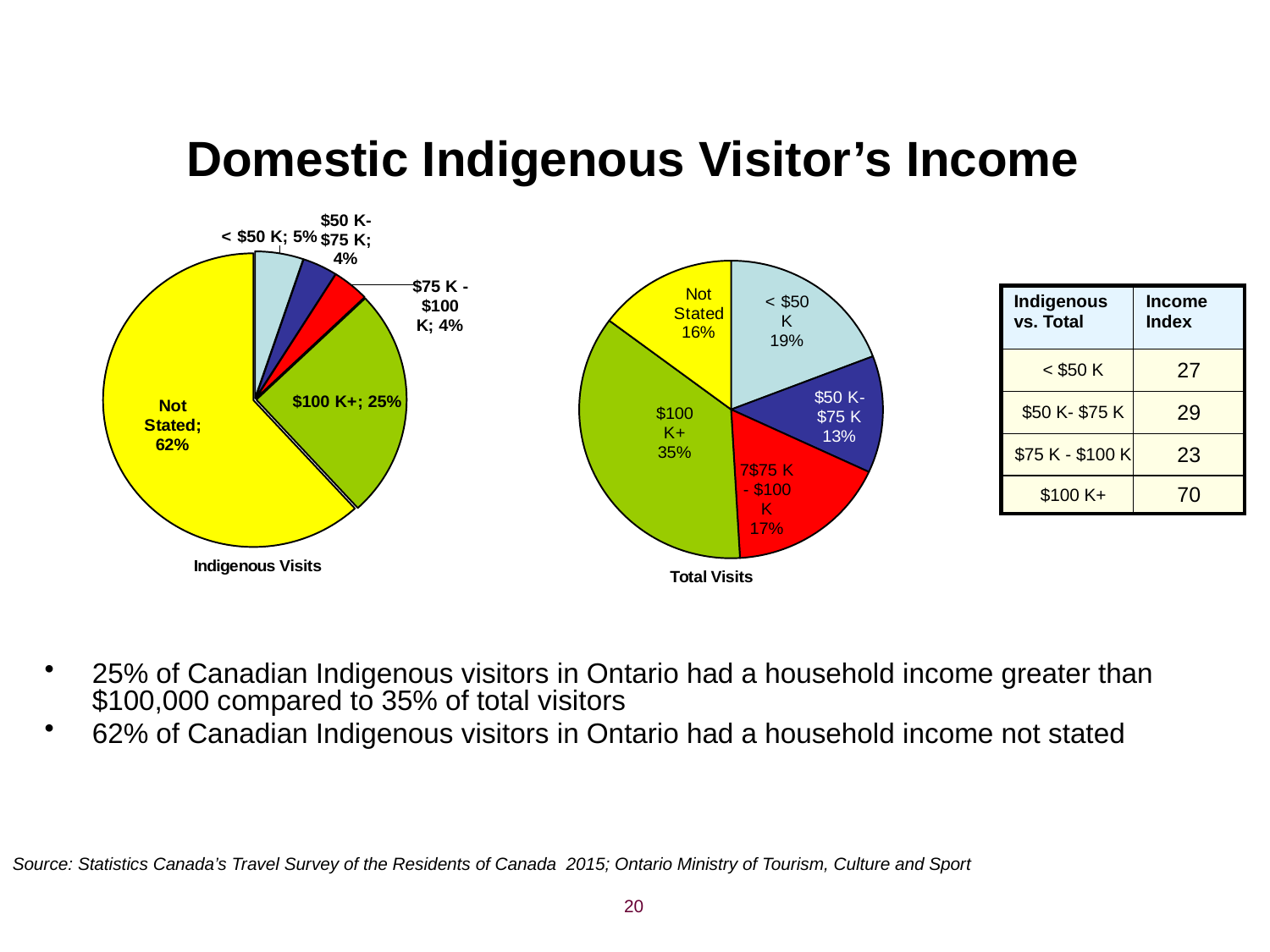
In the Indigenous Visits pie chart, what share of visits is Not Stated? 62% What is the difference between the $100 K+ share in the Total Visits pie chart and the $100 K+ share in the Indigenous Visits pie chart? 10 percentage points In the Indigenous Visits pie chart, which income category has the smallest share? $50 K-$75 K and $75 K - $100 K (both 4%) In the Total Visits pie chart, what share of visits is < $50 K? 19% In the Indigenous Visits pie chart, what share of visits is $100 K+? 25% In the Total Visits pie chart, which income category has the smallest share? $50 K-$75 K In the Indigenous Visits pie chart, what colour is the Not Stated slice? Yellow In the Total Visits pie chart, which income category has the largest share? $100 K+ How many slices does the Indigenous Visits pie chart have? 5 In the Total Visits pie chart, what share of visits is $100 K+? 35% What type of chart is used to show Total Visits? Pie chart In the Total Visits pie chart, which is larger: the share for < $50 K or the share for $75 K - $100 K? < $50 K